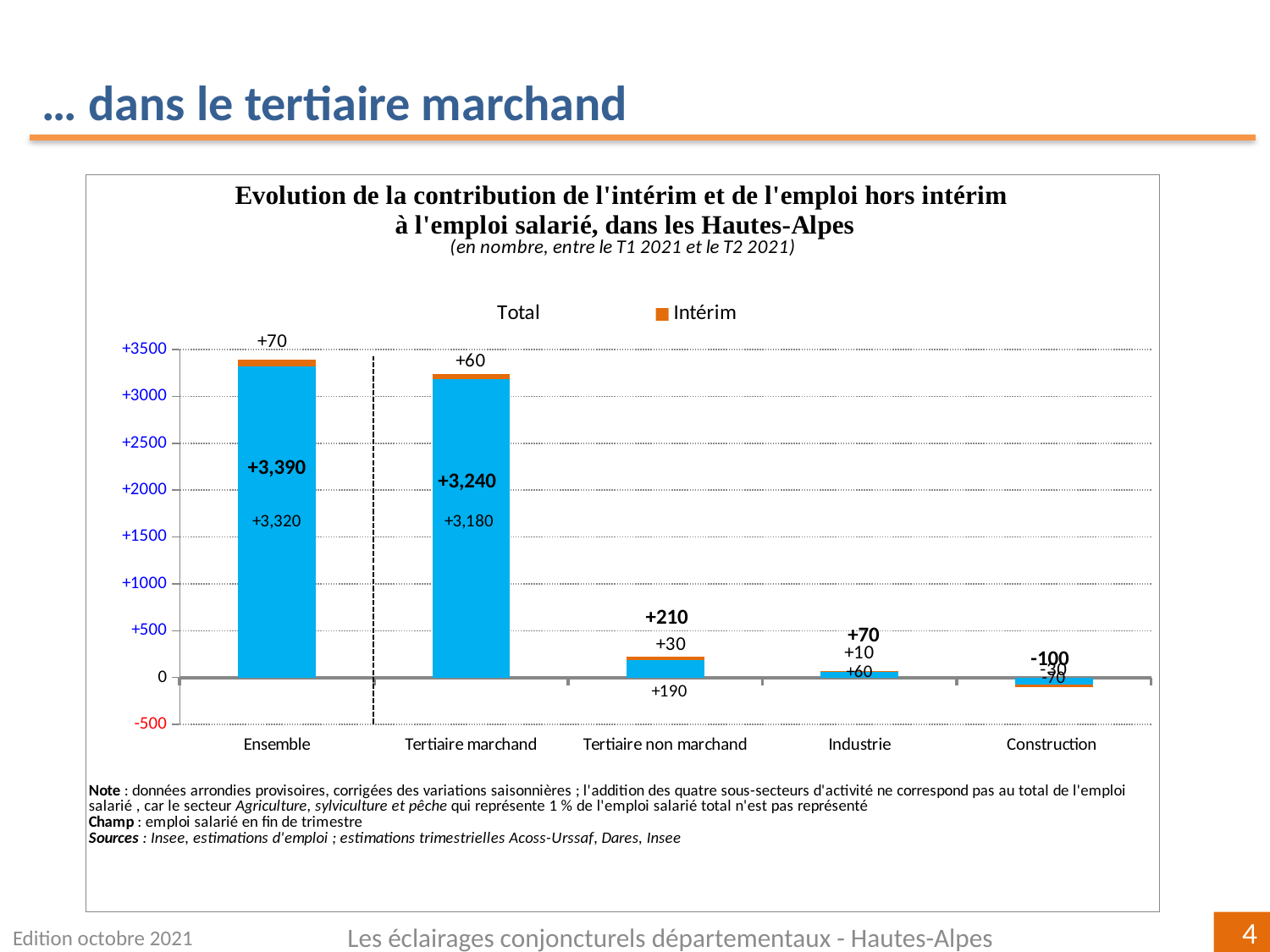
Which category has the highest total value? Ensemble What is the total value shown for Industrie? +70 Which is larger, the total for Tertiaire non marchand or the total for Industrie? Tertiaire non marchand What is the Intérim value for Ensemble? +70 How many categories are shown on the x axis? 5 What kind of chart is shown on the slide? Bar chart What is the total value shown for Tertiaire marchand? +3,240 Which category has the lowest total value? Construction What is the total value shown for Ensemble? +3,390 What is the difference between the total for Ensemble and the total for Tertiaire marchand? 150 What is the total value shown for Construction? -100 What is the Intérim value for Tertiaire non marchand? +30